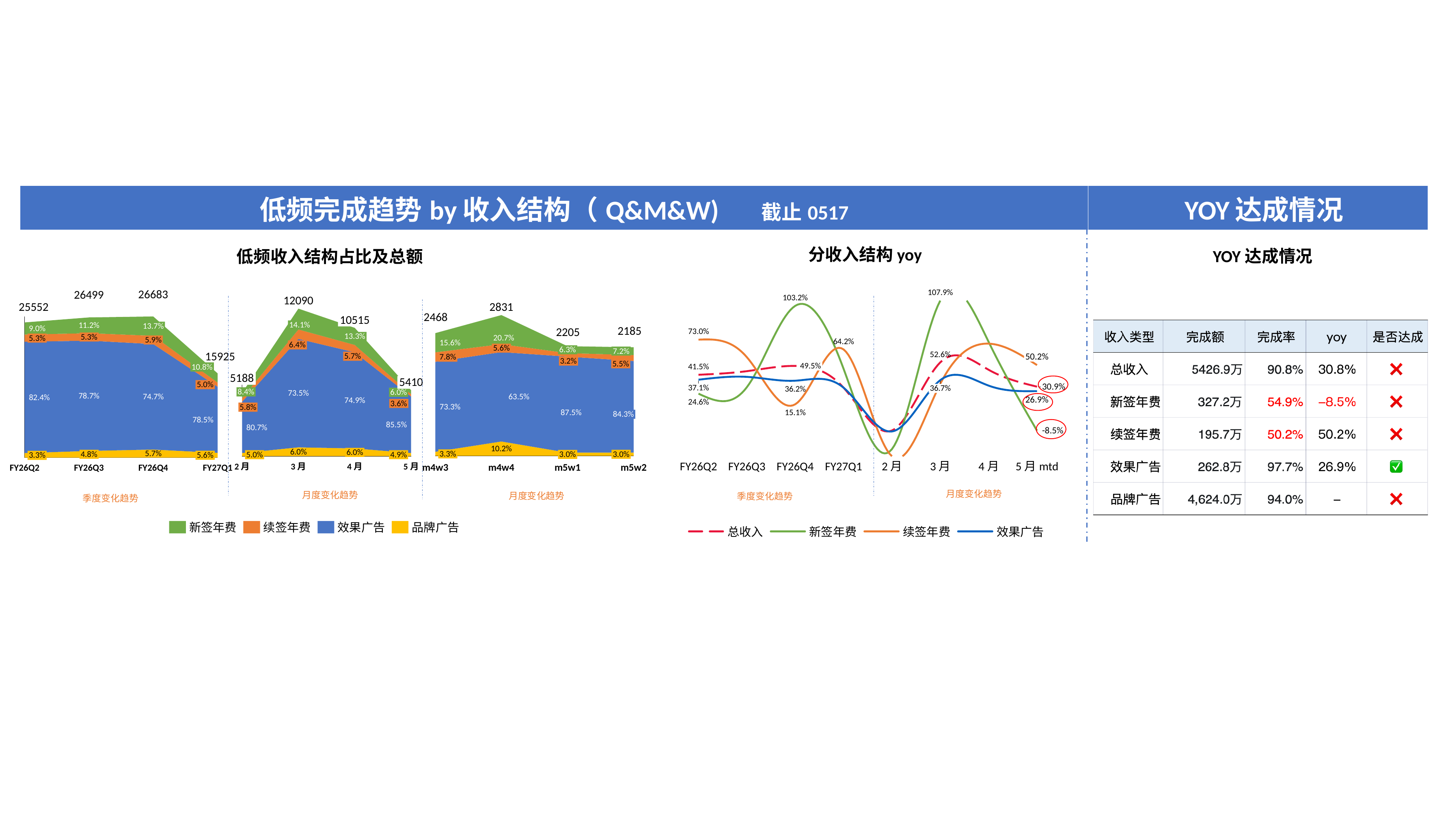
In the chart titled 低频收入结构占比及总额, what is the total shown for FY26Q4? 26683 In the chart titled 低频收入结构占比及总额, is the 品牌广告 share larger at m4w4 or at m5w1? m4w4 How many series does the legend of the chart titled 低频收入结构占比及总额 list? 4 In the chart titled 分收入结构 yoy, what is the 总收入 yoy value at 5月 mtd? 30.9% In the chart titled 低频收入结构占比及总额, what is the 新签年费 share at m4w4? 20.7% In the chart titled 分收入结构 yoy, what is the 续签年费 yoy value at FY26Q2? 73.0% In the chart titled 低频收入结构占比及总额, what is the difference between the 3月 total and the 4月 total? 1575 In the chart titled 低频收入结构占比及总额, which quarter among FY26Q2 to FY27Q1 has the highest total? FY26Q4 In the chart titled 低频收入结构占比及总额, which month among 2月, 3月, 4月 and 5月 has the highest total? 3月 What kind of chart is the chart titled 分收入结构 yoy? line chart In the chart titled 分收入结构 yoy, what is the 新签年费 yoy value at 5月 mtd? -8.5% In the chart titled 低频收入结构占比及总额, what is the 效果广告 share at m5w1? 87.5%